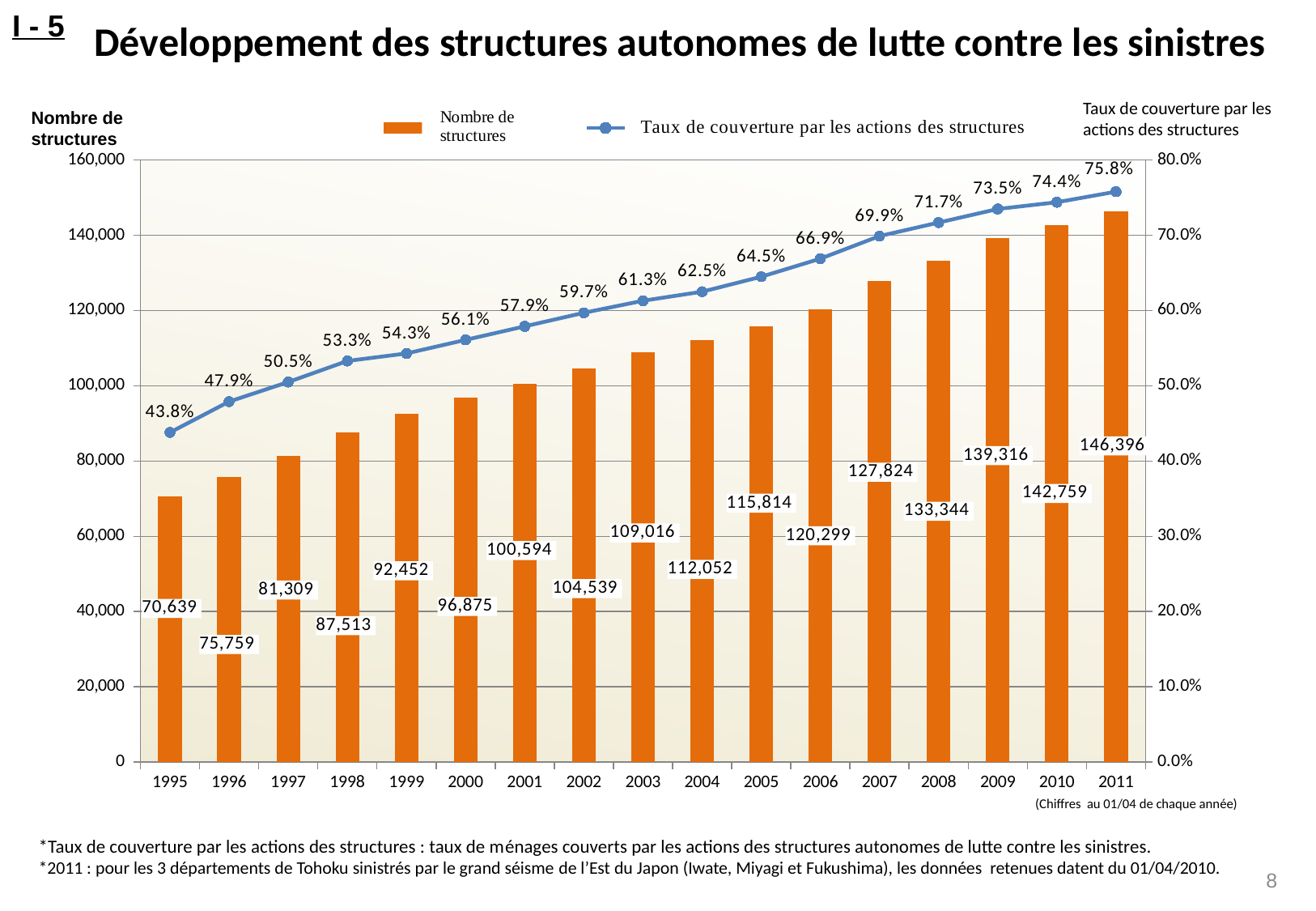
Which year has the lowest coverage rate? 1995 What colour are the bars for Nombre de structures? orange Does the coverage rate rise or fall from 1995 to 2011? rise Is the number of structures in 2000 greater or less than 100,000? less What is the coverage rate (Taux de couverture par les actions des structures) in 2007? 69.9% What is the number of structures (Nombre de structures) in 2003? 109,016 Which year has a higher number of structures, 2005 or 2006? 2006 How many series does the legend list? 2 What kind of chart is used for the Nombre de structures series? bar chart How many years are shown on the x axis? 17 What is the difference in the number of structures between 2011 and 1995? 75,757 Which year has the highest number of structures? 2011